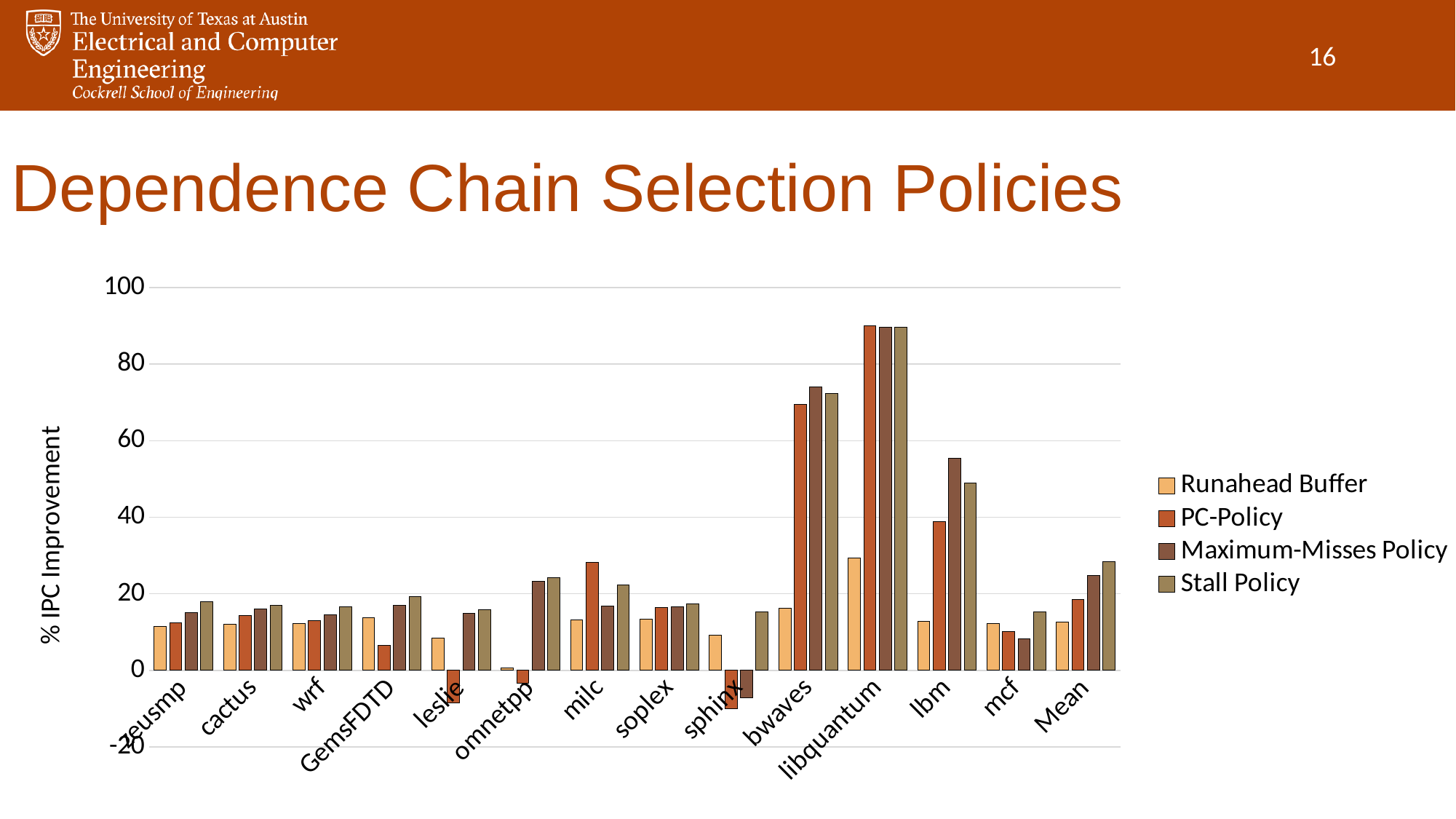
How many categories are shown along the x axis? 14 Is the Stall Policy value for libquantum greater or less than 80? greater How many series does the legend list? 4 Is the Runahead Buffer value for libquantum greater or less than 20? greater For milc, which is larger, the PC-Policy value or the Stall Policy value? PC-Policy For lbm, which is larger, the Maximum-Misses Policy value or the Stall Policy value? Maximum-Misses Policy What is the label on the y axis of the chart? % IPC Improvement Is the PC-Policy value for bwaves greater or less than 60? greater What kind of chart is shown on the slide? bar chart Which category has the highest Stall Policy value? libquantum